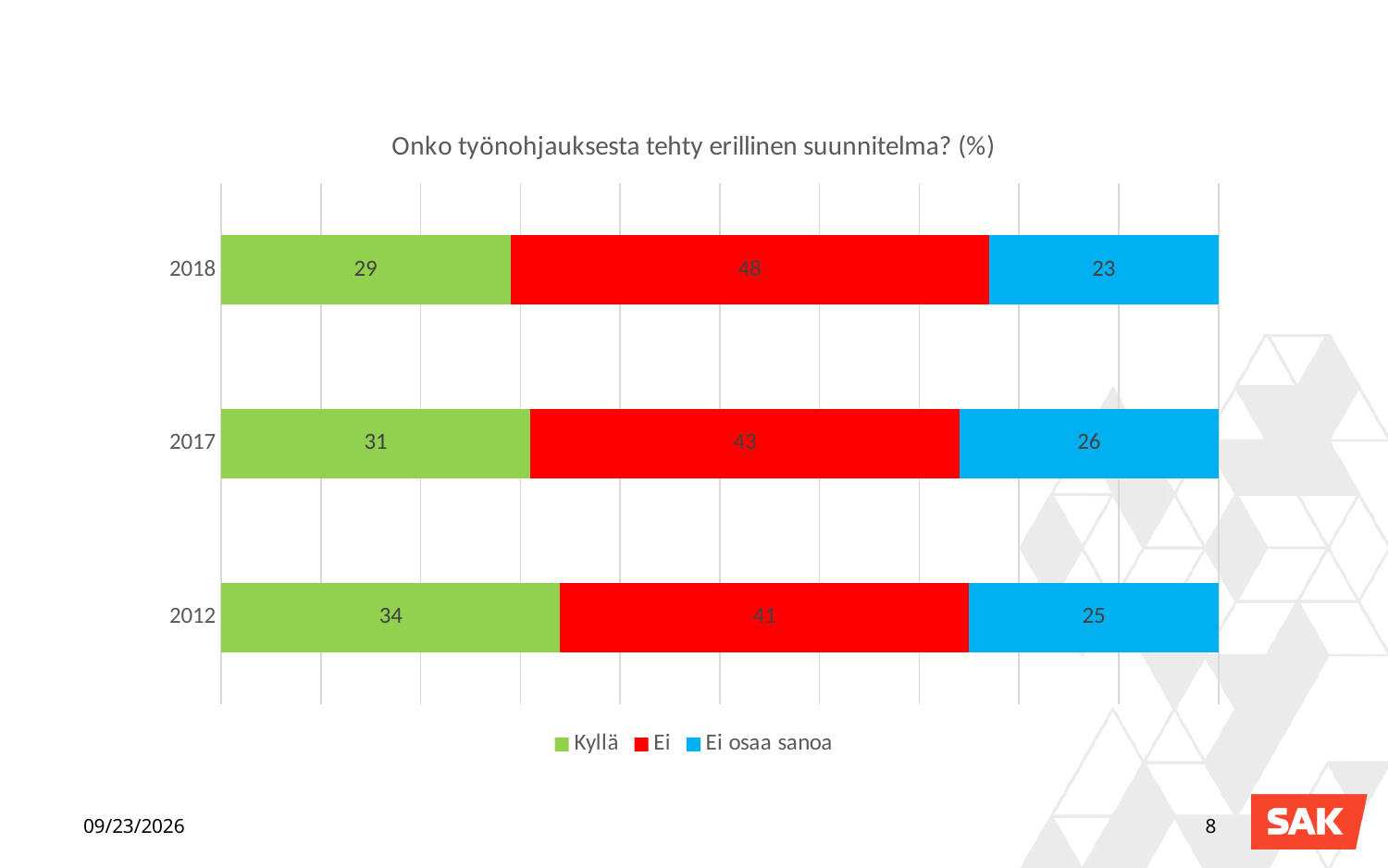
What is the difference between the Ei value in 2018 and the Ei value in 2012? 7 How many series does the legend list? 3 What is the value for Ei in 2017? 43 What is the title of the chart? Onko työnohjauksesta tehty erillinen suunnitelma? (%) How many years are shown on the chart? 3 What is the total of the stacked bar for 2017? 100 Which is larger: the Ei osaa sanoa value in 2017 or in 2018? 2017 What is the value for Kyllä in 2018? 29 What is the value for Ei osaa sanoa in 2012? 25 Which year has the highest value for Ei? 2018 What kind of chart is shown on the slide? Stacked bar chart Which year has the lowest value for Kyllä? 2018